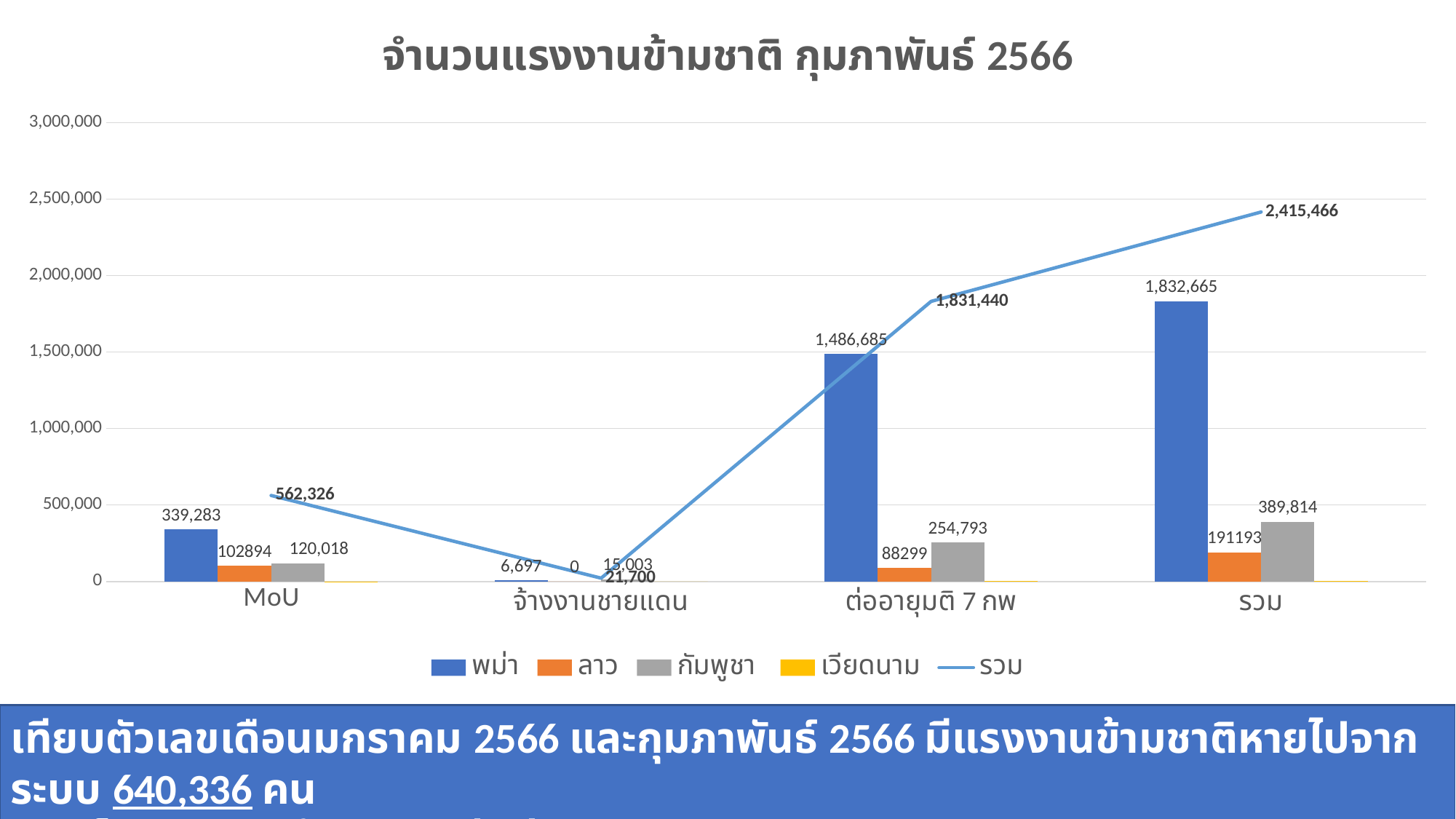
What is the title of the chart? จำนวนแรงงานข้ามชาติ กุมภาพันธ์ 2566 What is the value of the รวม line at the รวม category? 2,415,466 What is the value for ลาว in the จ้างงานชายแดน category? 0 What is the value for กัมพูชา in the รวม category? 389,814 What is the value for พม่า in the MoU category? 339,283 Which category has the lowest value on the รวม line? จ้างงานชายแดน How many series does the legend list? 5 Which category has the highest value for พม่า? รวม In the MoU category, which is larger: the value for ลาว or the value for กัมพูชา? กัมพูชา What is the difference between the พม่า value and the กัมพูชา value in the ต่ออายุมติ 7 กพ category? 1,231,892 What is the value of the รวม line at ต่ออายุมติ 7 กพ? 1,831,440 How many categories are shown on the x axis? 4